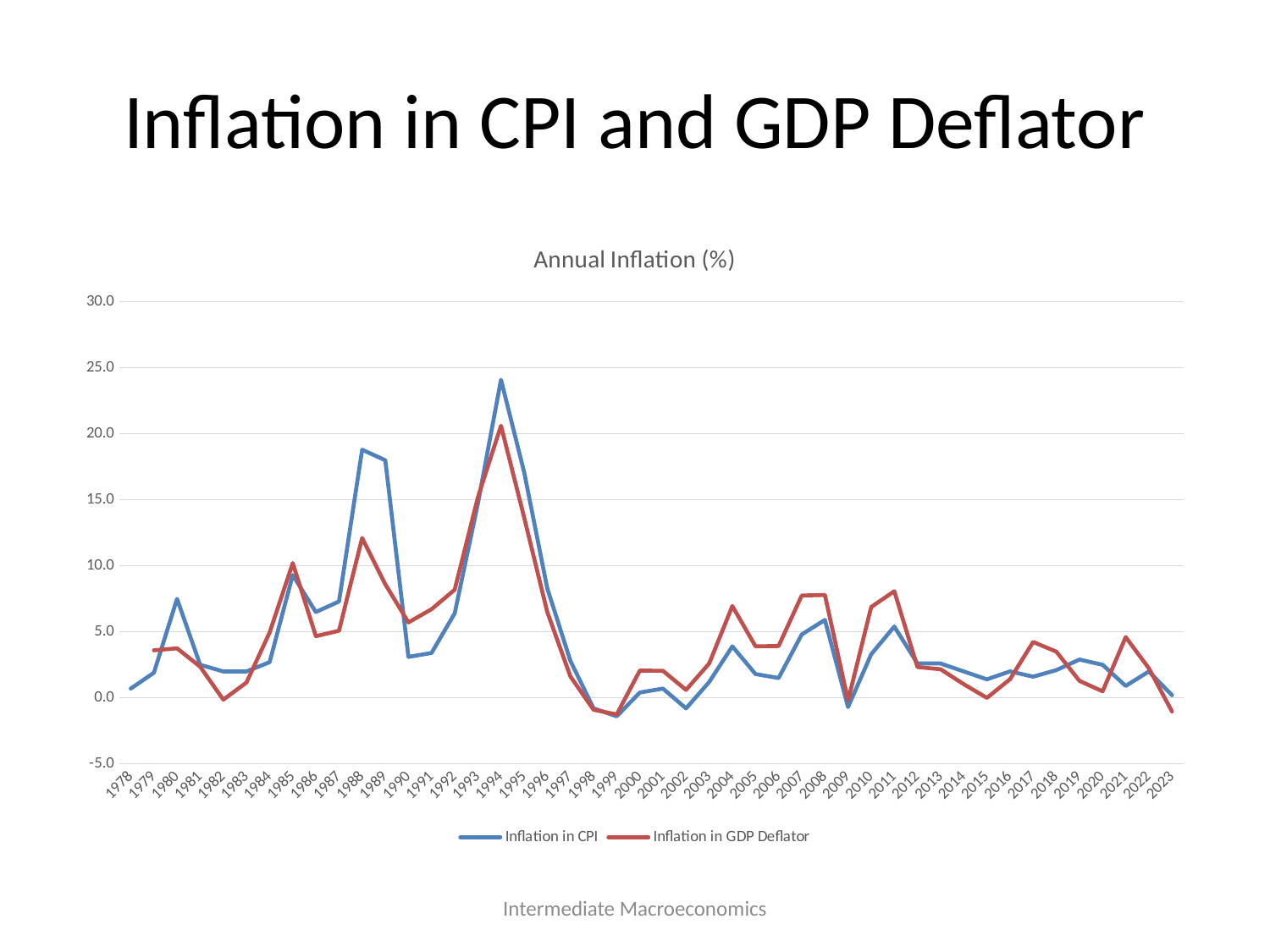
How many series does the legend list? 2 Is the value for Inflation in CPI in 1994 greater or less than 20.0? greater In which year does Inflation in CPI reach its highest value? 1994 How many years are plotted along the x axis? 46 Is the value for Inflation in CPI in 1988 greater or less than 15.0? greater What is the title of the chart? Annual Inflation (%) In 2011, which series has the larger value, Inflation in CPI or Inflation in GDP Deflator? Inflation in GDP Deflator In 1988, which series has the larger value, Inflation in CPI or Inflation in GDP Deflator? Inflation in CPI Is the value for Inflation in GDP Deflator in 2023 greater or less than 0.0? less What kind of chart is shown on the slide? line chart In which year does Inflation in GDP Deflator reach its highest value? 1994